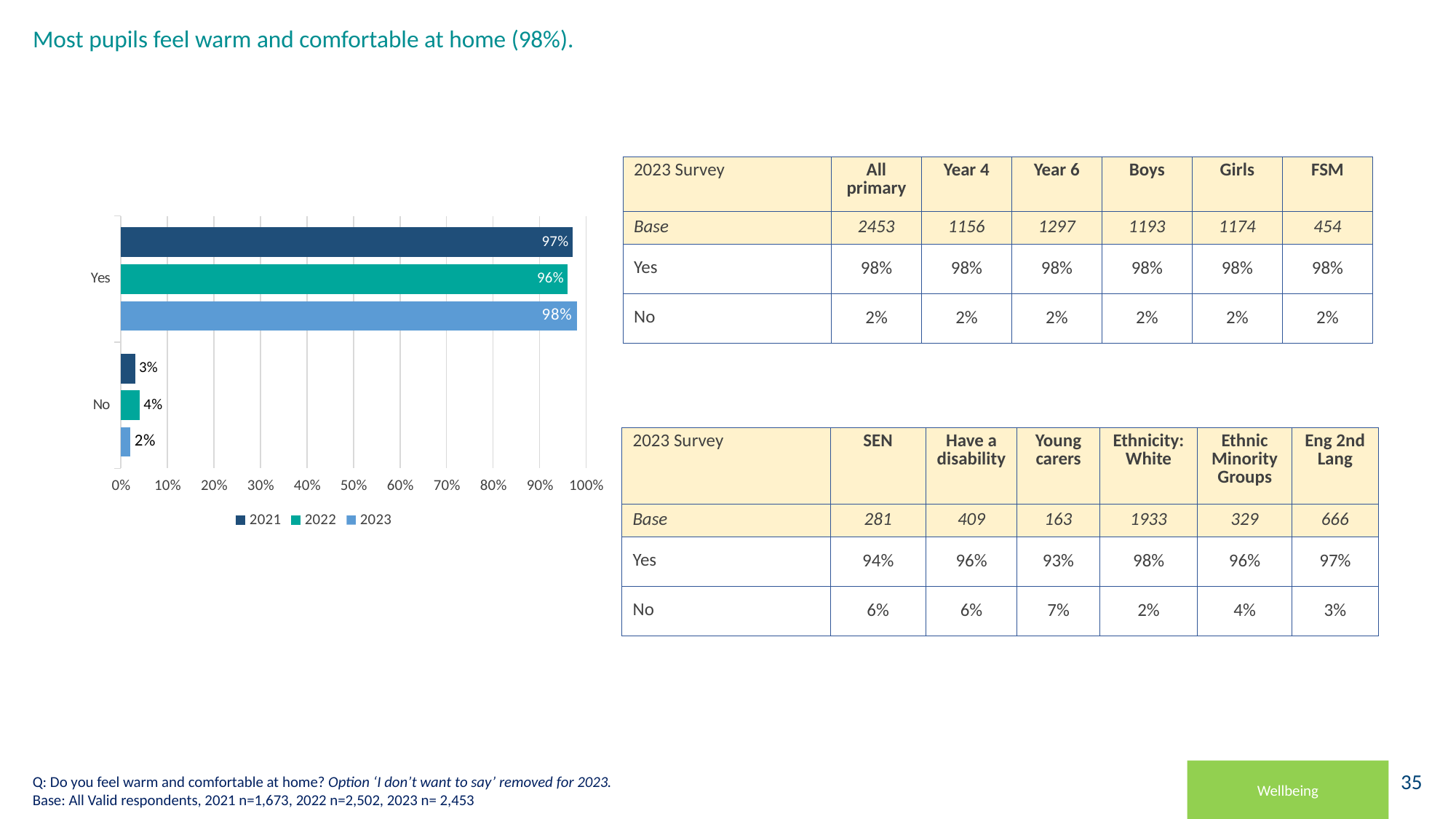
How many categories are shown on the chart? 2 Is the value for Yes in 2022 greater or less than 90%? greater Which year has the highest value for Yes? 2023 What is the value for Yes in 2021? 97% What is the difference between the Yes values for 2023 and 2022? 2% What kind of chart is shown on the slide? bar chart What is the value for No in 2022? 4% Which year has the lowest value for No? 2023 How many series does the legend list? 3 What is the value for Yes in 2023? 98% What is the value for No in 2021? 3% Which is larger, the No value for 2022 or the No value for 2021? 2022